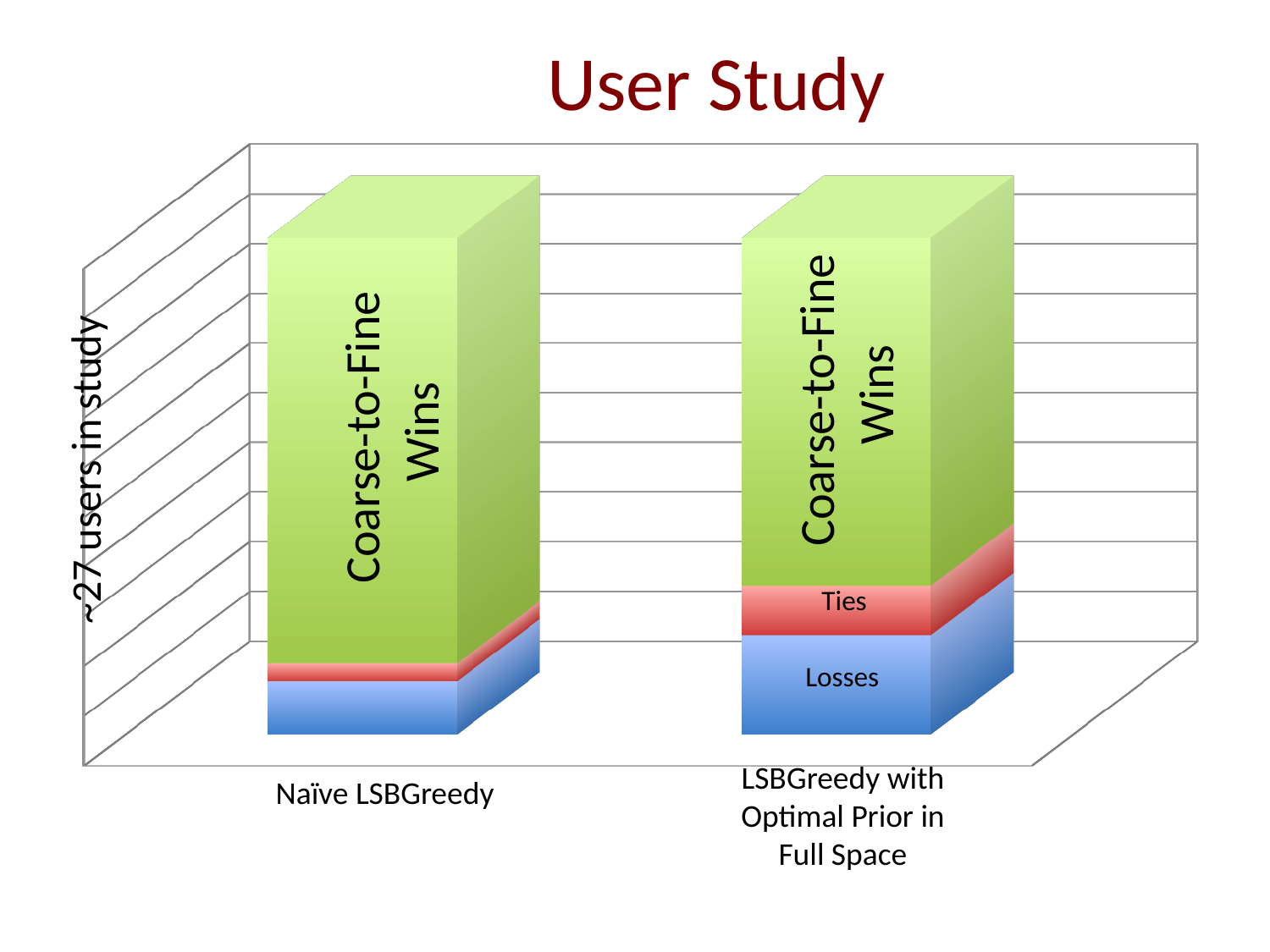
What kind of chart is shown on the slide? stacked bar chart Which category has the larger Coarse-to-Fine Wins segment, Naïve LSBGreedy or LSBGreedy with Optimal Prior in Full Space? Naïve LSBGreedy Which segment is the smallest in the Naïve LSBGreedy bar? Ties How many categories are shown along the x axis of the chart? 2 Does the Coarse-to-Fine Wins segment rise or fall from Naïve LSBGreedy to LSBGreedy with Optimal Prior in Full Space? fall Which category has the larger Losses segment, Naïve LSBGreedy or LSBGreedy with Optimal Prior in Full Space? LSBGreedy with Optimal Prior in Full Space What is the title of the chart on the slide? User Study Which segment makes up the largest part of the LSBGreedy with Optimal Prior in Full Space bar? Coarse-to-Fine Wins Which segment makes up the largest part of the Naïve LSBGreedy bar? Coarse-to-Fine Wins What is the label on the vertical axis of the chart? ~27 users in study Which category has the larger Ties segment, Naïve LSBGreedy or LSBGreedy with Optimal Prior in Full Space? LSBGreedy with Optimal Prior in Full Space How many stacked segments does each bar in the chart contain? 3